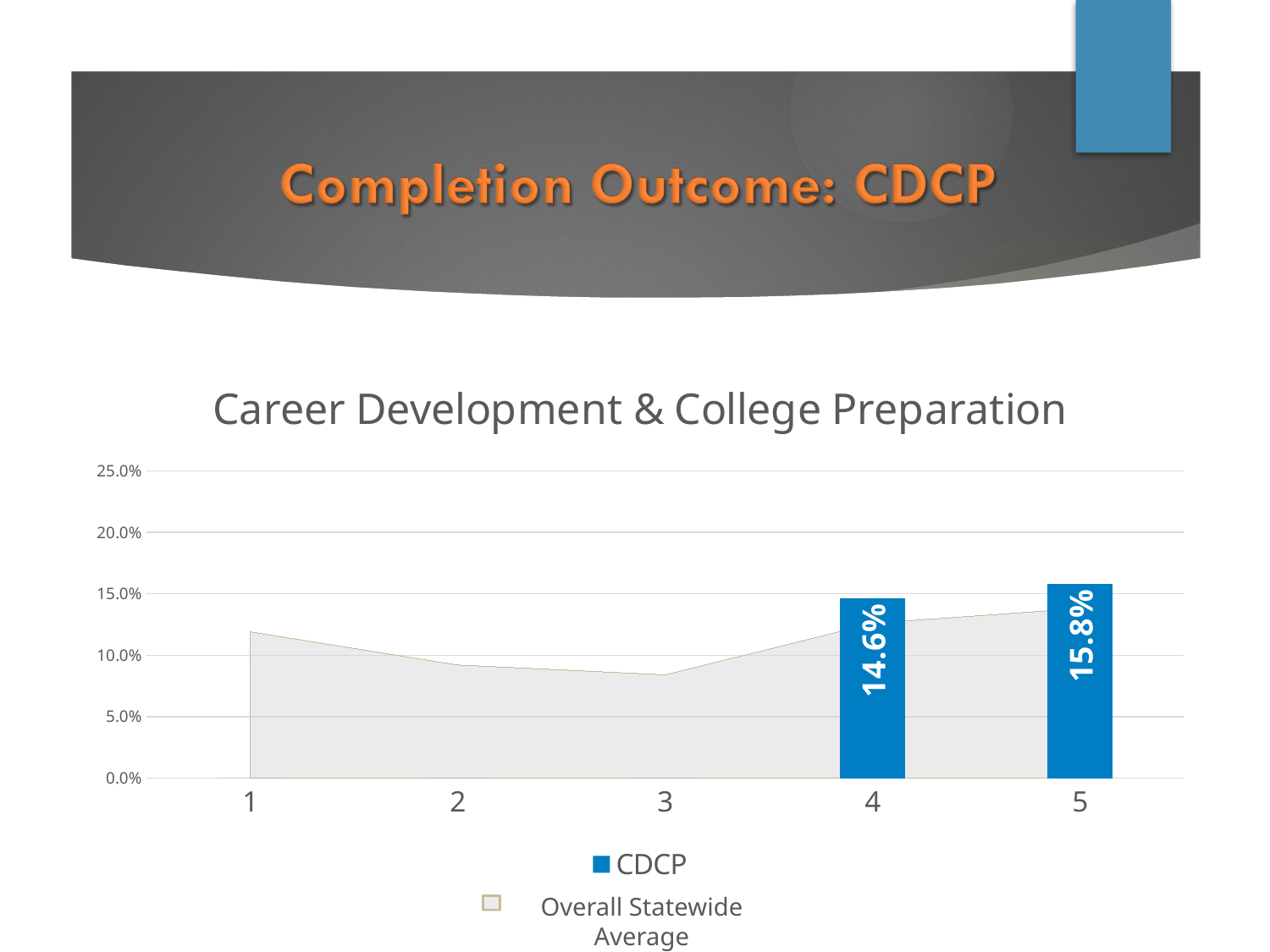
Is the Overall Statewide Average value for category 1 greater or less than 10.0%? greater What is the CDCP value for category 5? 15.8% How many series does the legend list? 2 What is the title of the chart? Career Development & College Preparation Which category has the highest CDCP value? 5 Is the Overall Statewide Average value for category 3 greater or less than 10.0%? less Does the Overall Statewide Average rise or fall from category 3 to category 5? Rise Which category has the higher CDCP value, 4 or 5? 5 What is the difference between the CDCP values for categories 5 and 4? 1.2% What kind of chart is used to plot the CDCP series? Bar chart How many categories are shown on the x axis? 5 What is the CDCP value for category 4? 14.6%